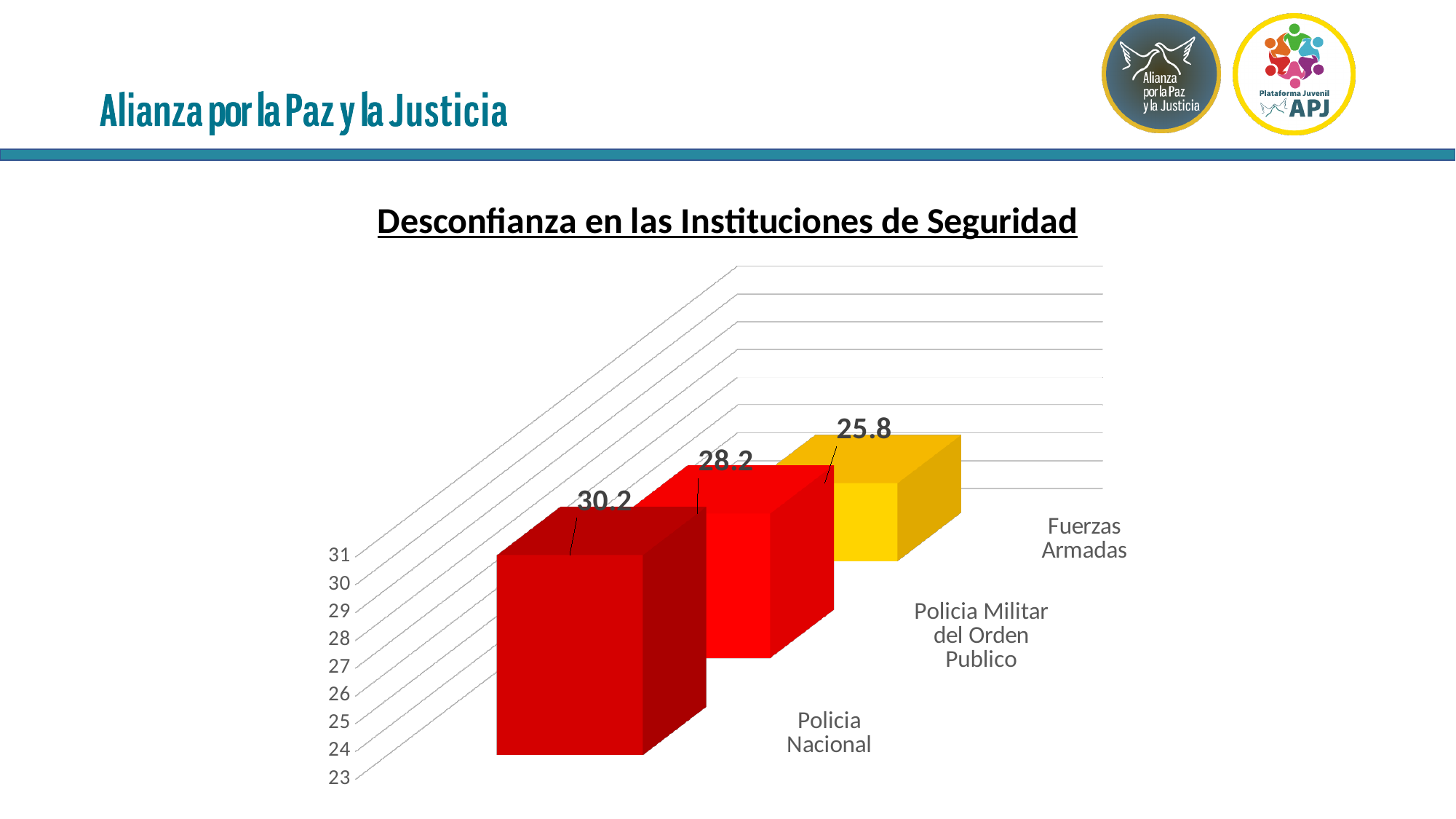
What is the title of the chart? Desconfianza en las Instituciones de Seguridad What kind of chart is shown on the slide? bar chart Which is larger, the value for Policia Militar del Orden Publico or the value for Fuerzas Armadas? Policia Militar del Orden Publico Is the value for Fuerzas Armadas greater or less than 27? less Which category has the lowest value? Fuerzas Armadas What is the difference between the values for Policia Nacional and Policia Militar del Orden Publico? 2 What is the value for Policia Militar del Orden Publico? 28.2 How many categories are shown in the chart? 3 What is the value for Policia Nacional? 30.2 What is the value for Fuerzas Armadas? 25.8 Which category has the highest value? Policia Nacional What is the difference between the values for Policia Nacional and Fuerzas Armadas? 4.4